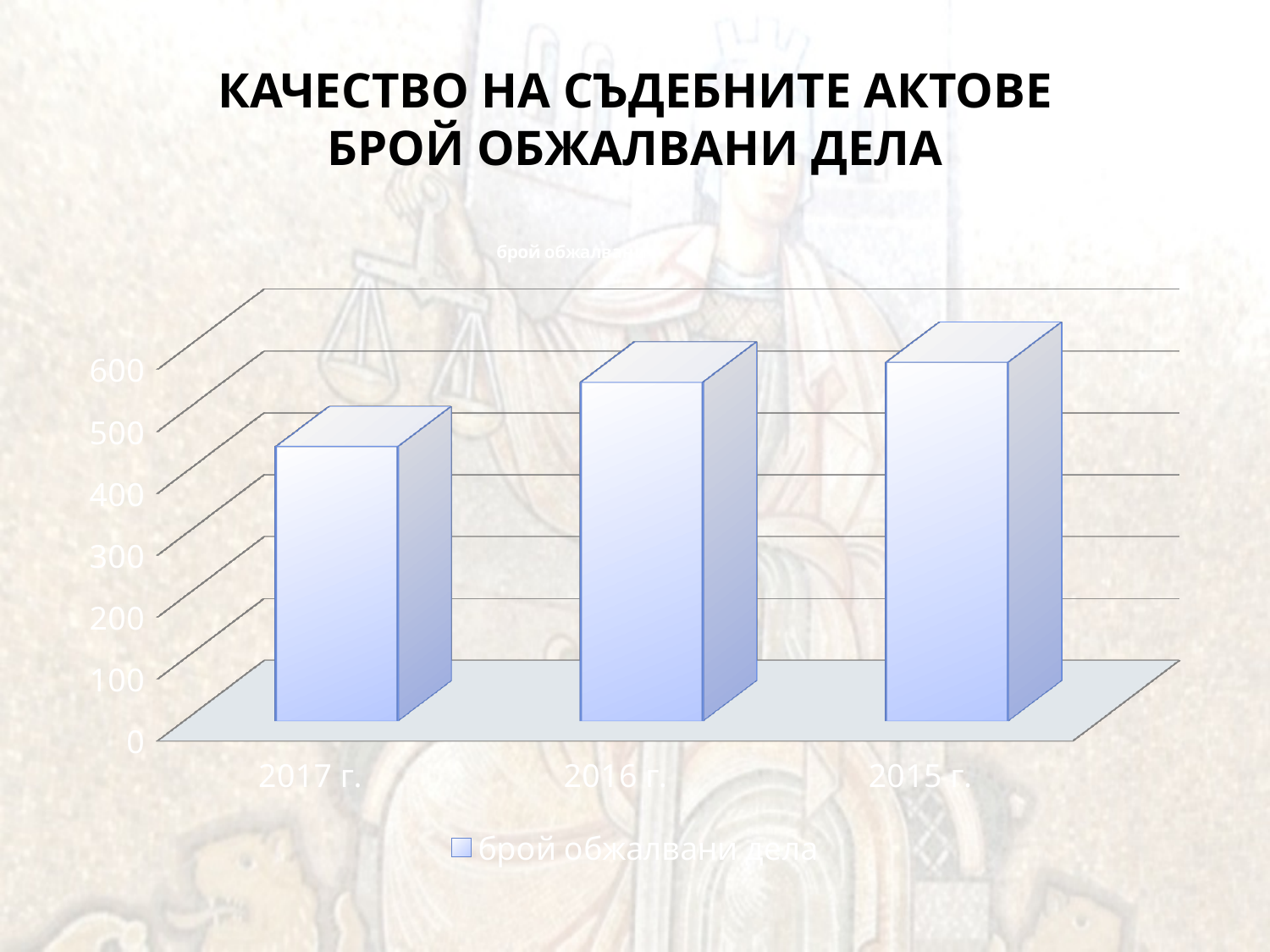
Is the value for 2017 г. greater or less than 400? greater Do the values rise or fall moving left to right along the x axis from 2017 г. to 2015 г.? rise Which year has the highest number of appealed cases in the chart? 2015 г. What is the series name shown in the chart legend? брой обжалвани дела Is the value for 2015 г. greater or less than 500? greater How many series does the chart legend list? 1 How many categories (years) are shown on the x axis of the chart? 3 Is the value for 2017 г. greater or less than 600? less What kind of chart is shown on the slide? bar chart Which is larger, the value for 2016 г. or the value for 2017 г.? 2016 г. Which year has the lowest number of appealed cases in the chart? 2017 г.